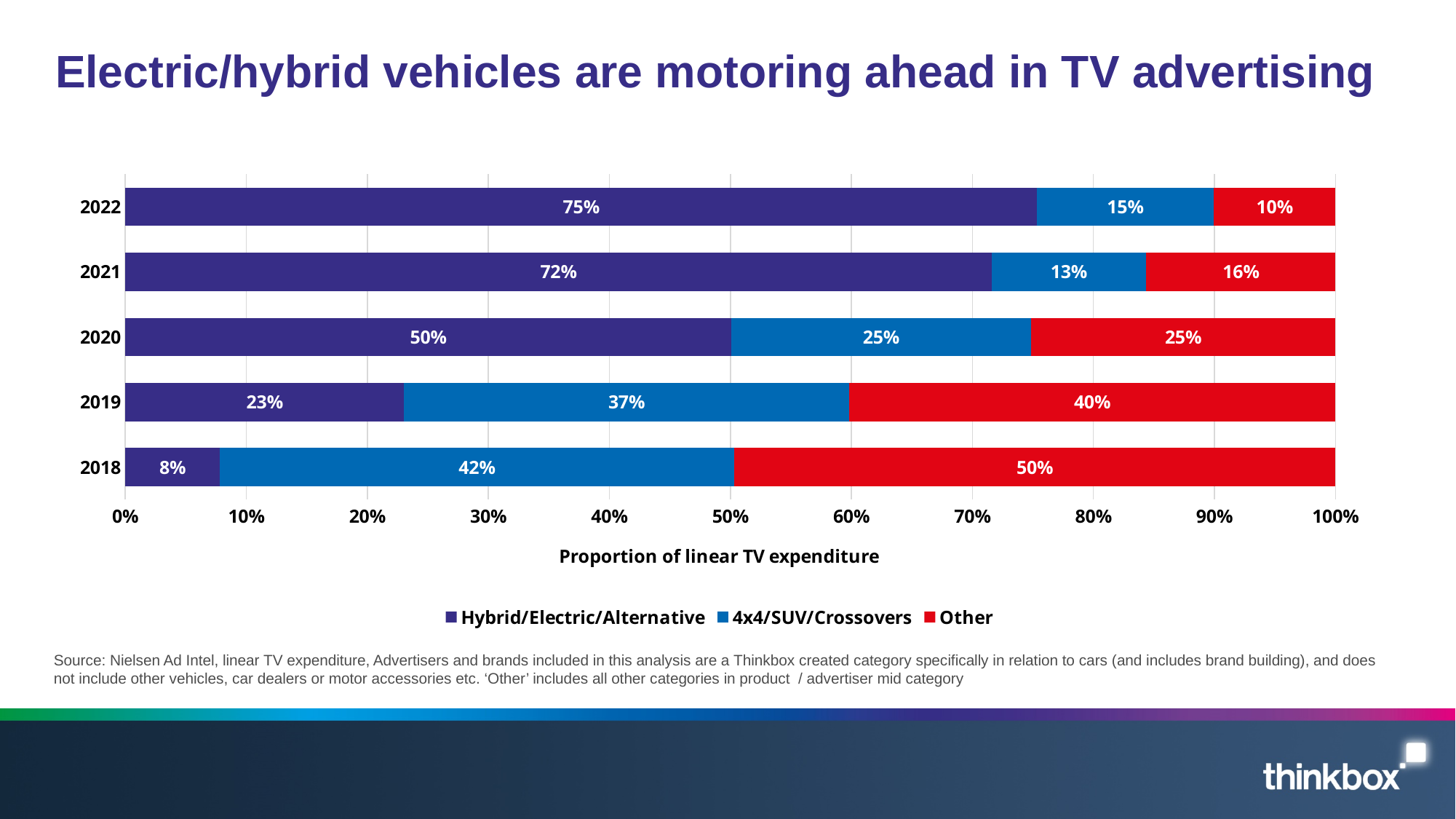
What is the Other share in 2020? 25% Which is larger in 2019: the 4x4/SUV/Crossovers share or the Other share? Other How many series does the legend list? 3 What kind of chart is shown on the slide? Stacked bar chart In which year is the Hybrid/Electric/Alternative share lowest? 2018 What is the Hybrid/Electric/Alternative share of linear TV expenditure in 2022? 75% How many years are shown on the chart? 5 What is the 4x4/SUV/Crossovers share in 2018? 42% What is the x-axis title of the chart? Proportion of linear TV expenditure What is the difference between the Hybrid/Electric/Alternative share in 2022 and in 2018? 67 percentage points In which year is the Hybrid/Electric/Alternative share highest? 2022 Does the Other share rise or fall from 2018 to 2022? Fall